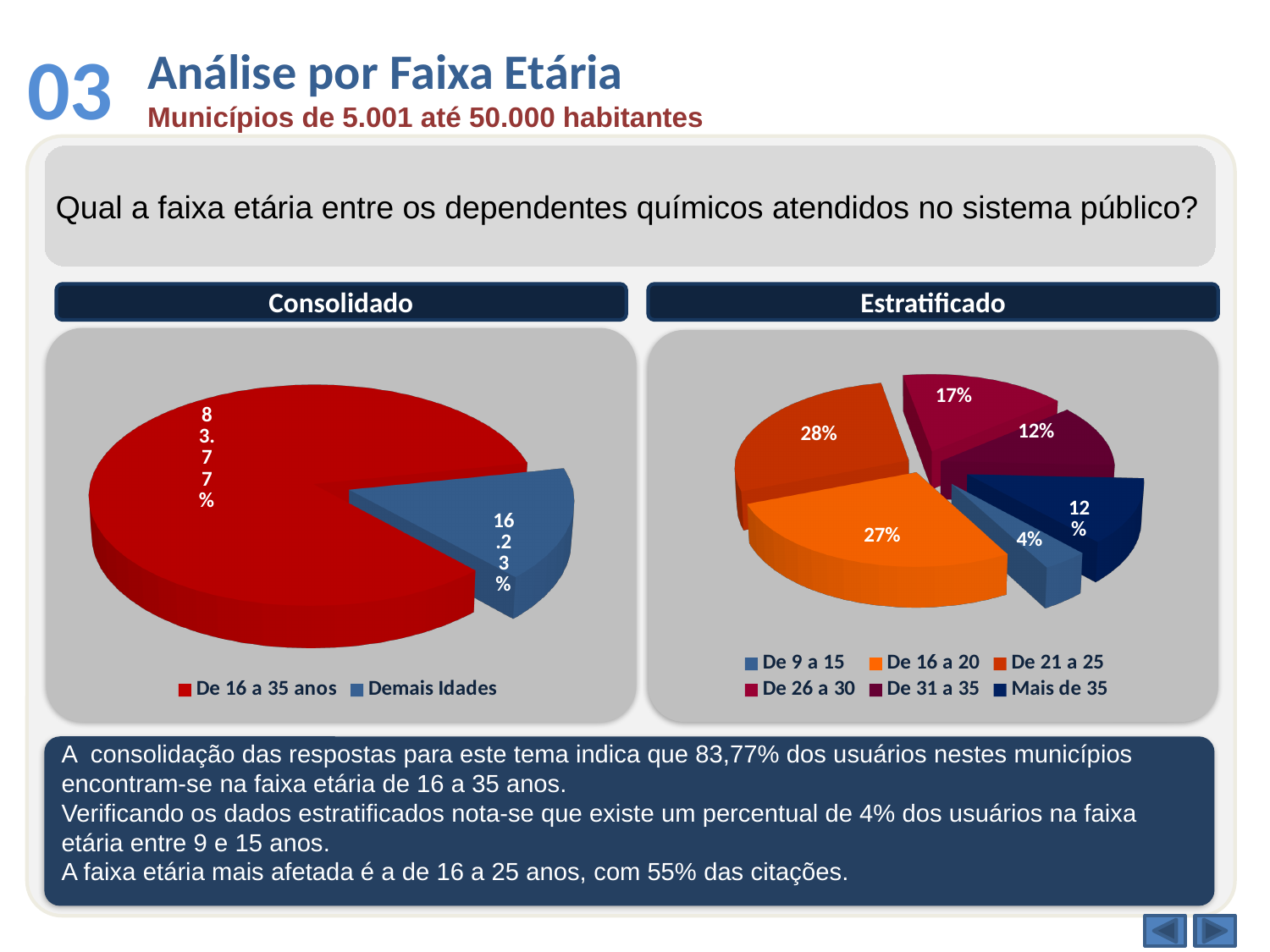
In the Estratificado chart, which is larger: De 16 a 20 or De 31 a 35? De 16 a 20 In the Consolidado chart, what is the value for De 16 a 35 anos? 83.77% In the Consolidado chart, how many slices are there? 2 In the Consolidado chart, what is the value for Demais Idades? 16.23% In the Estratificado chart, which category has the smallest share? De 9 a 15 In the Estratificado chart, what is the value for De 9 a 15? 4% In the Estratificado chart, what is the difference between De 16 a 20 and De 26 a 30? 10% In the Estratificado chart, what is the value for De 21 a 25? 28% What kind of chart is the Consolidado chart? Pie chart In the Estratificado chart, what is the value for De 26 a 30? 17% In the Estratificado chart, how many categories does the legend list? 6 In the Estratificado chart, which category has the largest share? De 21 a 25